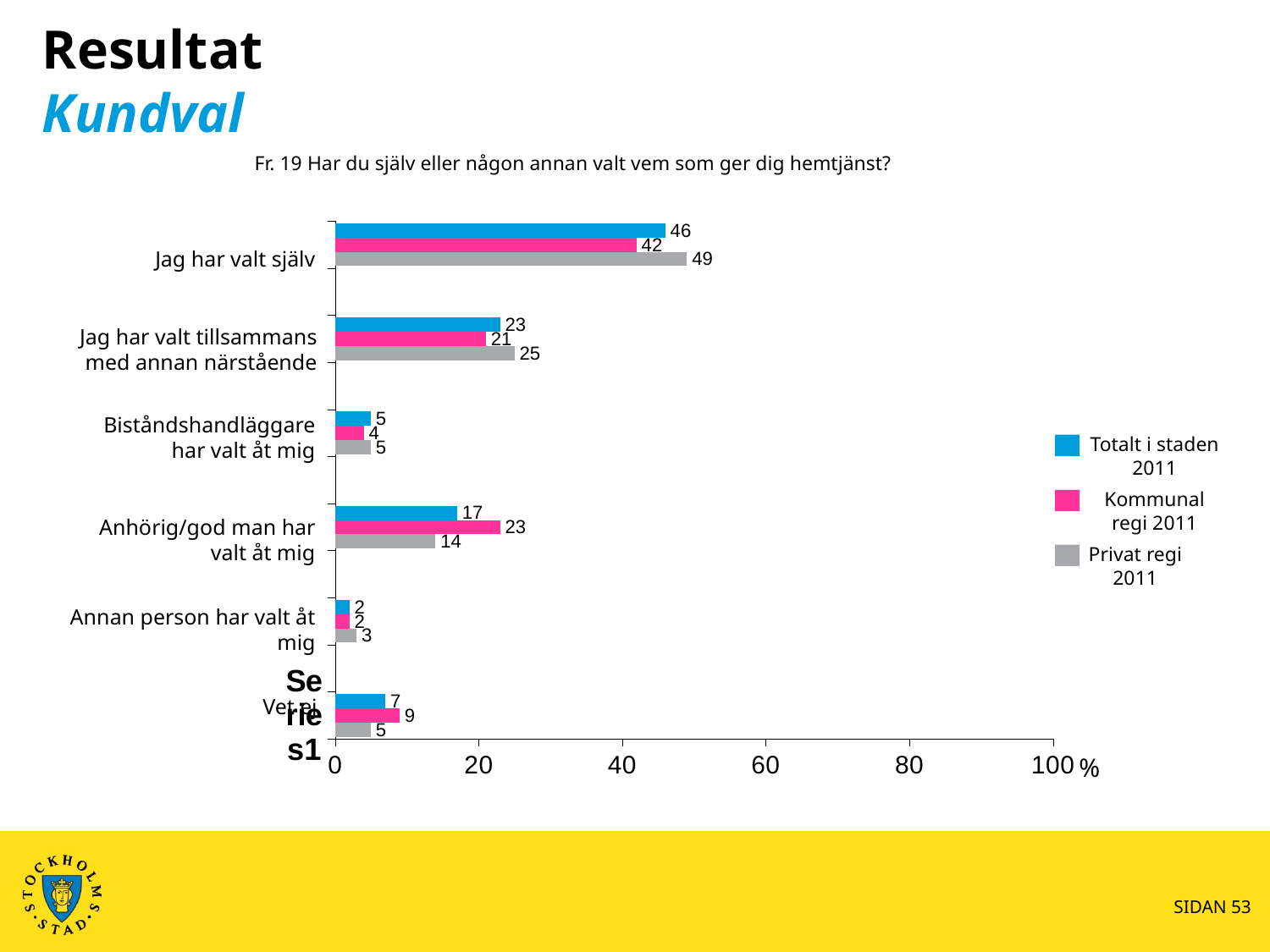
Which colour represents the Kommunal regi 2011 series? Pink What is the value for 'Jag har valt själv' in the Privat regi 2011 series? 49 For 'Anhörig/god man har valt åt mig', which series has the larger value: Kommunal regi 2011 or Privat regi 2011? Kommunal regi 2011 What is the value for 'Anhörig/god man har valt åt mig' in the Kommunal regi 2011 series? 23 What is the value for 'Jag har valt tillsammans med annan närstående' in the Privat regi 2011 series? 25 What kind of chart is shown on the slide? Bar chart What is the difference between the Privat regi 2011 and Kommunal regi 2011 values for 'Jag har valt själv'? 7 What is the value for 'Jag har valt själv' in the Totalt i staden 2011 series? 46 Is the Totalt i staden 2011 value for 'Jag har valt själv' greater or less than 40? greater How many series does the legend list? 3 Which category has the highest value in the Totalt i staden 2011 series? Jag har valt själv Which category has the lowest value in the Privat regi 2011 series? Annan person har valt åt mig